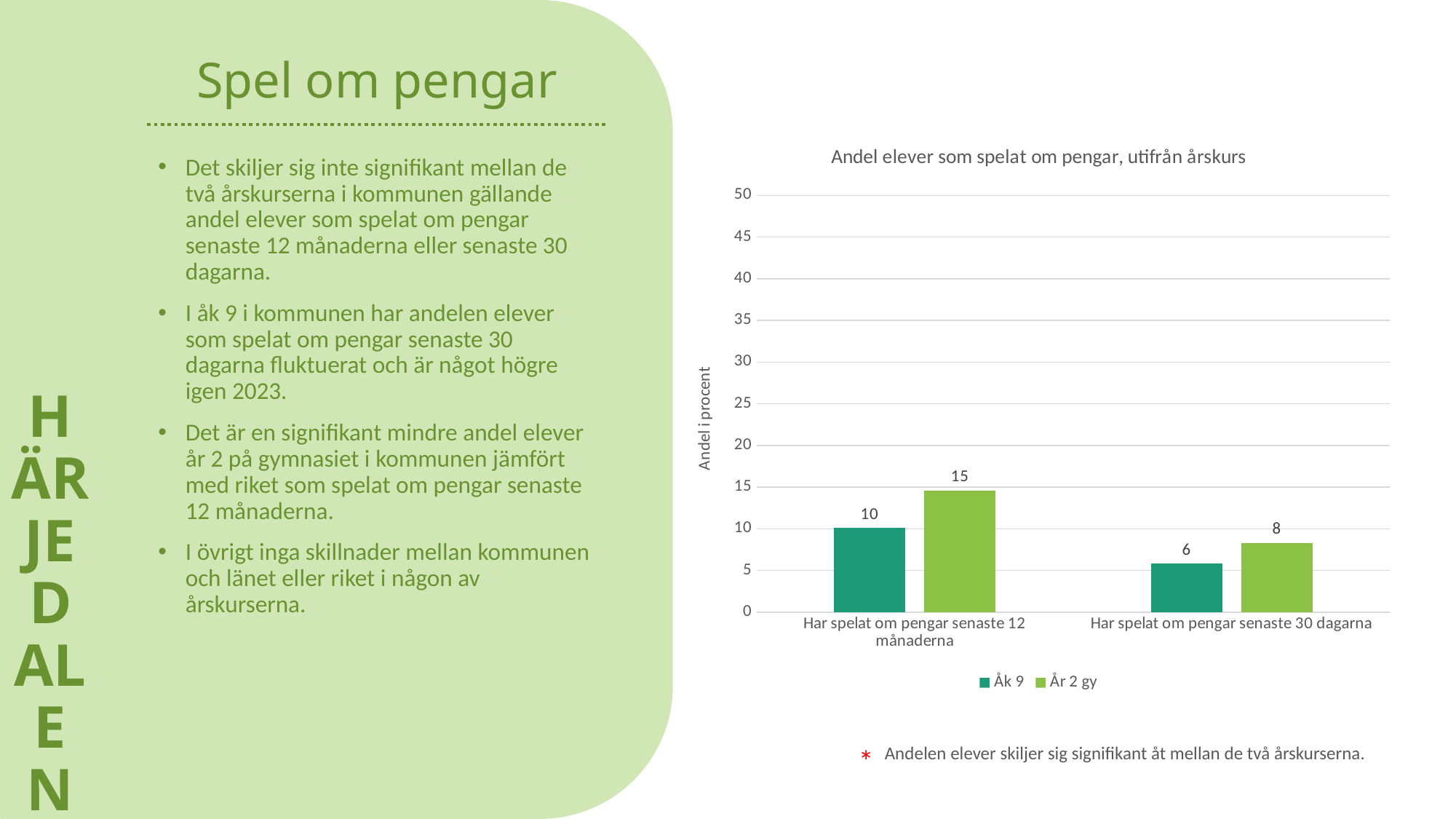
What is the value for År 2 gy in the category 'Har spelat om pengar senaste 30 dagarna'? 8 What is the value for Åk 9 in the category 'Har spelat om pengar senaste 12 månaderna'? 10 Which is larger for 'Har spelat om pengar senaste 30 dagarna': Åk 9 or År 2 gy? År 2 gy How many categories are shown on the x axis? 2 Which series has the highest value in the chart? År 2 gy What is the difference between År 2 gy and Åk 9 for 'Har spelat om pengar senaste 12 månaderna'? 5 Is the value for År 2 gy in 'Har spelat om pengar senaste 12 månaderna' greater or less than 20? less What is the value for År 2 gy in the category 'Har spelat om pengar senaste 12 månaderna'? 15 What is the value for Åk 9 in the category 'Har spelat om pengar senaste 30 dagarna'? 6 Which bar has the lowest value in the chart? Åk 9, Har spelat om pengar senaste 30 dagarna What type of chart is shown on the slide? Bar chart How many series does the legend list? 2